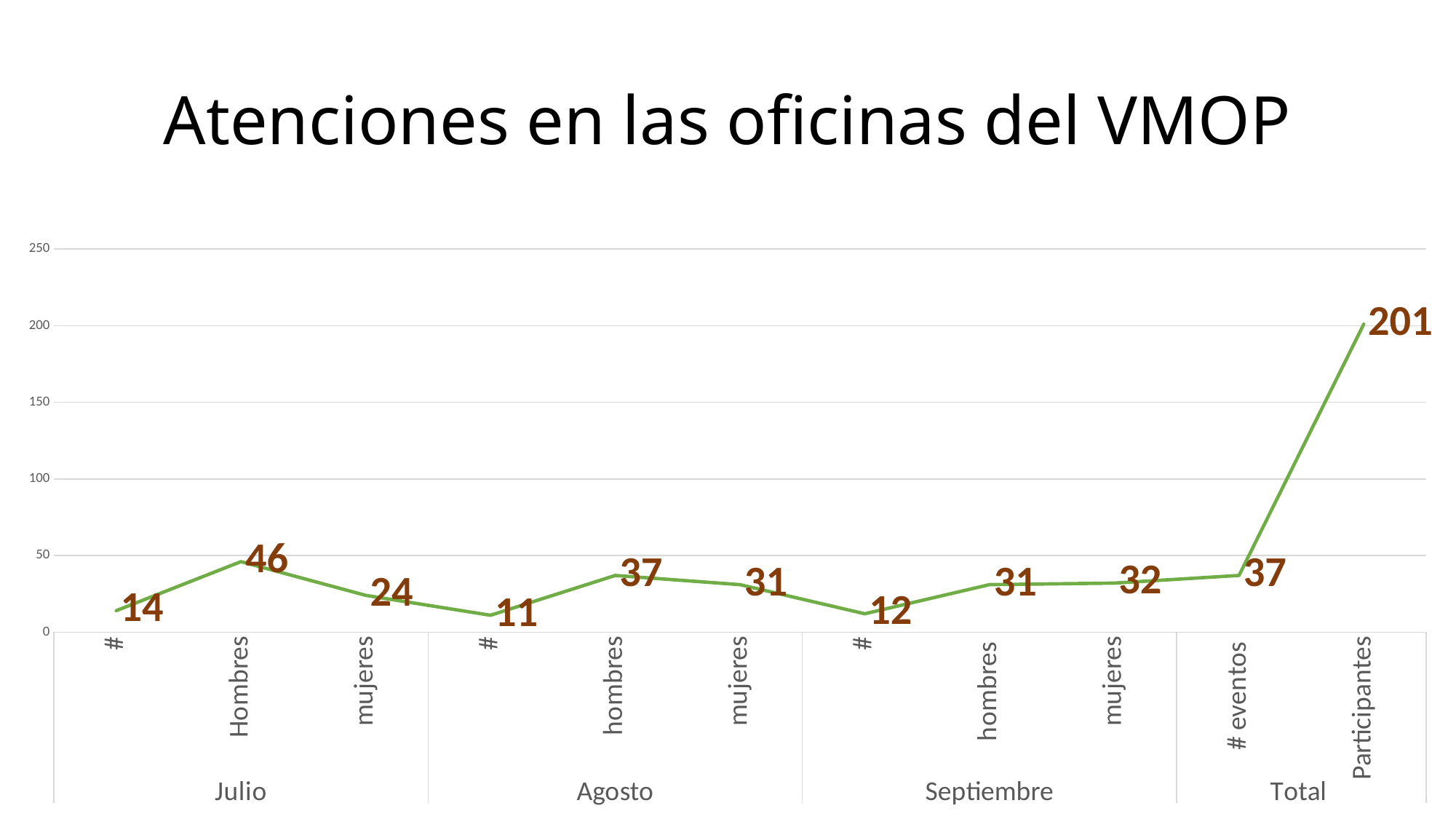
What is the difference between Hombres in Julio and mujeres in Julio? 22 Which data point has the lowest value? # in Agosto What type of chart is shown on the slide? line chart What is the value for # in Septiembre? 12 Is the value for Participantes greater or less than 150? greater Which is larger, hombres in Agosto or hombres in Septiembre? hombres in Agosto Which data point has the highest value? Participantes (Total) How many data points are plotted on the line? 11 What is the value for mujeres in Agosto? 31 What is the value for Participantes under Total? 201 What is the title of the chart? Atenciones en las oficinas del VMOP What is the value for Hombres in Julio? 46